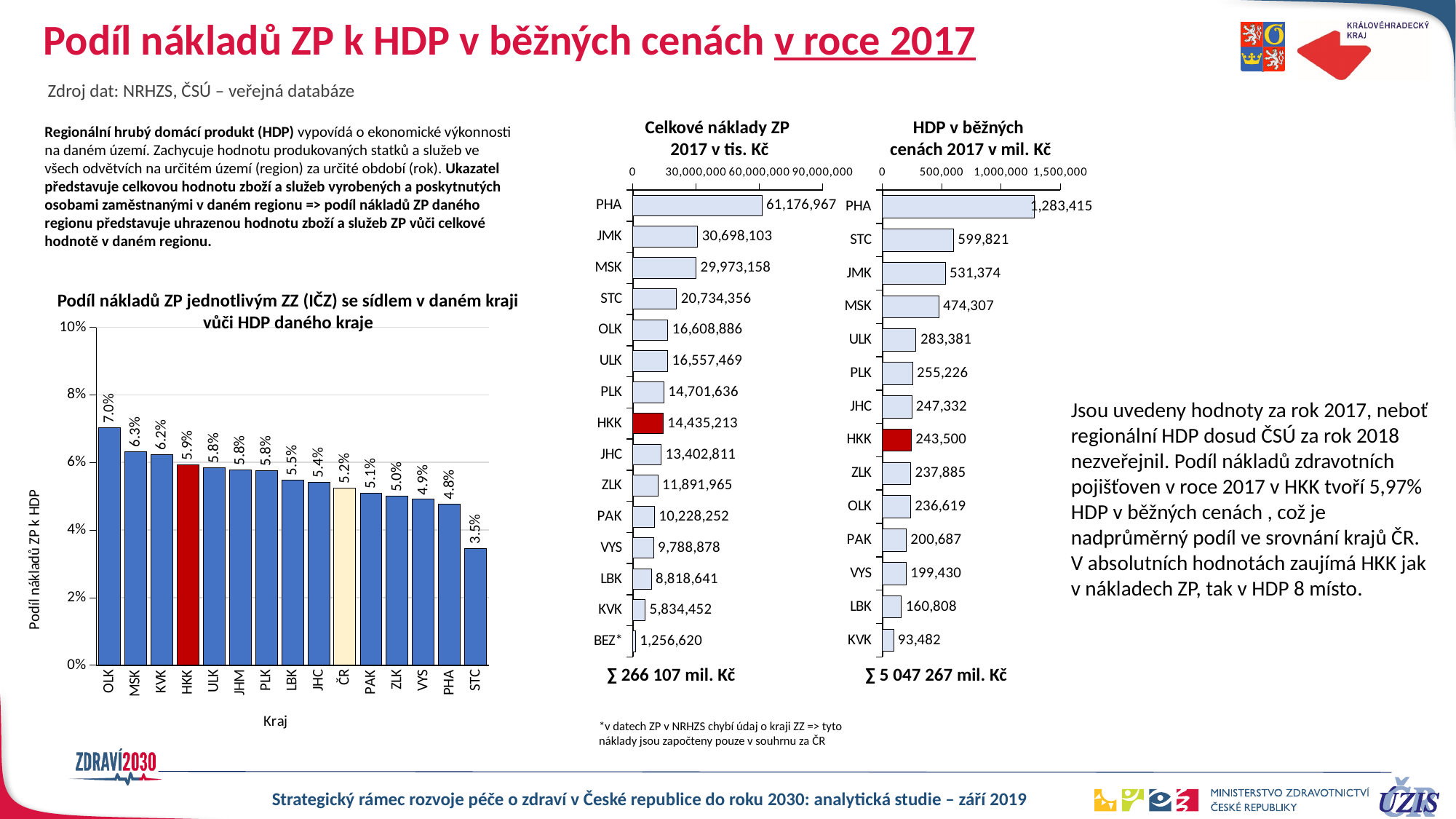
In the chart 'Podíl nákladů ZP jednotlivým ZZ (IČZ) se sídlem v daném kraji vůči HDP daného kraje', what is the difference between the values for OLK and STC? 3.5% In the chart 'Podíl nákladů ZP jednotlivým ZZ (IČZ) se sídlem v daném kraji vůči HDP daného kraje', which region has the highest value? OLK What type of chart is 'HDP v běžných cenách 2017 v mil. Kč'? Bar chart In the chart 'Celkové náklady ZP 2017 v tis. Kč', what is the value for HKK? 14,435,213 In the chart 'Celkové náklady ZP 2017 v tis. Kč', which is larger, the value for JMK or the value for MSK? JMK In the chart 'HDP v běžných cenách 2017 v mil. Kč', how many regions are shown? 14 In the chart 'HDP v běžných cenách 2017 v mil. Kč', which region has the lowest value? KVK In the chart 'Podíl nákladů ZP jednotlivým ZZ (IČZ) se sídlem v daném kraji vůči HDP daného kraje', how many bars are shown? 15 In the chart 'HDP v běžných cenách 2017 v mil. Kč', what is the value for STC? 599,821 In the chart 'Podíl nákladů ZP jednotlivým ZZ (IČZ) se sídlem v daném kraji vůči HDP daného kraje', what is the value for HKK? 5.9% In the chart 'Celkové náklady ZP 2017 v tis. Kč', which region has the highest value? PHA In the chart 'Podíl nákladů ZP jednotlivým ZZ (IČZ) se sídlem v daném kraji vůči HDP daného kraje', which region has the lowest value? STC